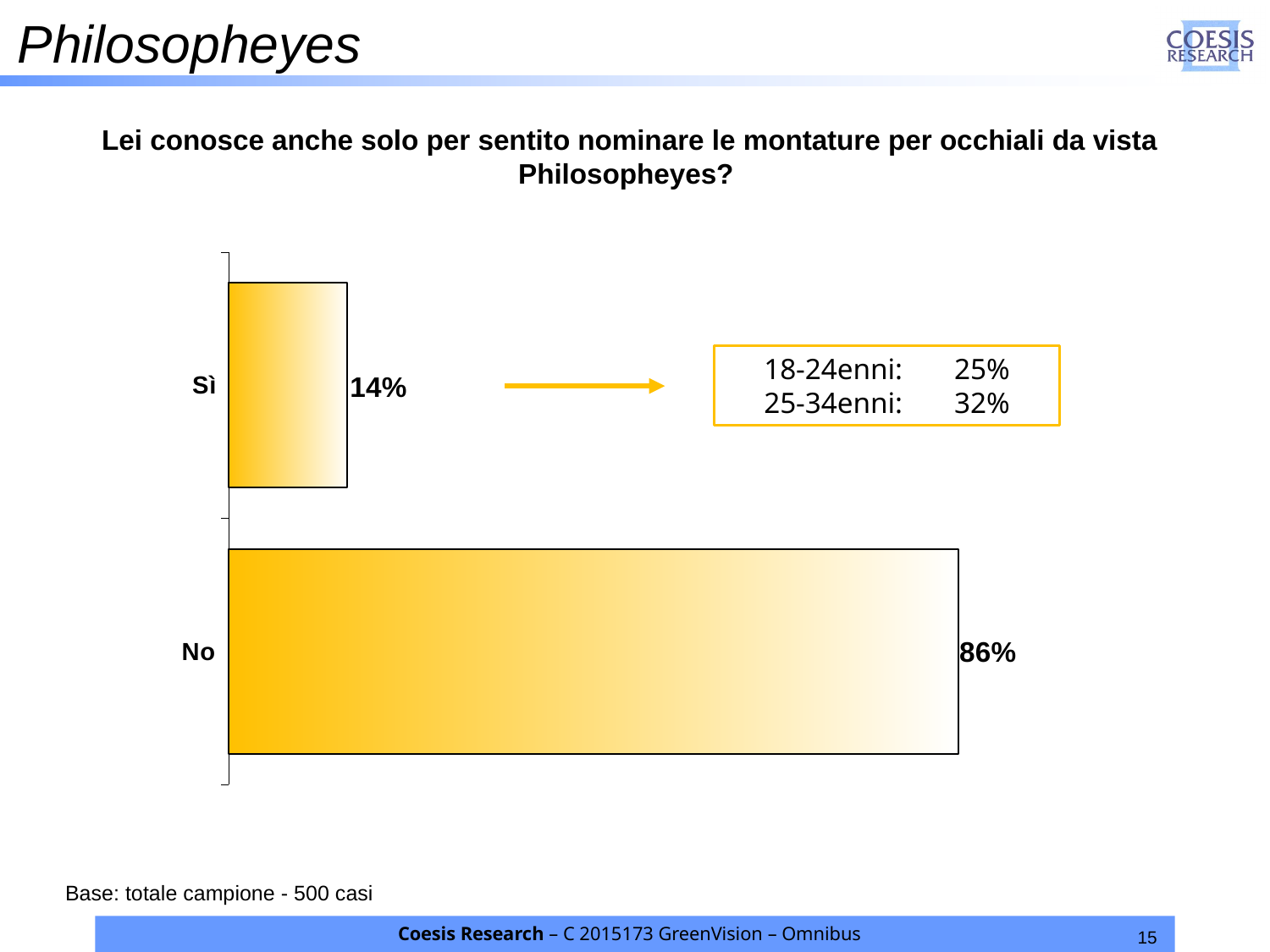
What kind of chart is shown on the slide? Bar chart Which is larger, the value for "Sì" or the value for "No"? No Which category has the lowest value? Sì What is the value for "Sì"? 14% How many categories are shown in the chart? 2 What is the value for "No"? 86% What is the total of the two values shown in the chart? 100% What is the difference between the values for "No" and "Sì"? 72% According to the callout box, what is the value for 25-34enni? 32% According to the callout box, what is the value for 18-24enni? 25% Which category has the highest value? No